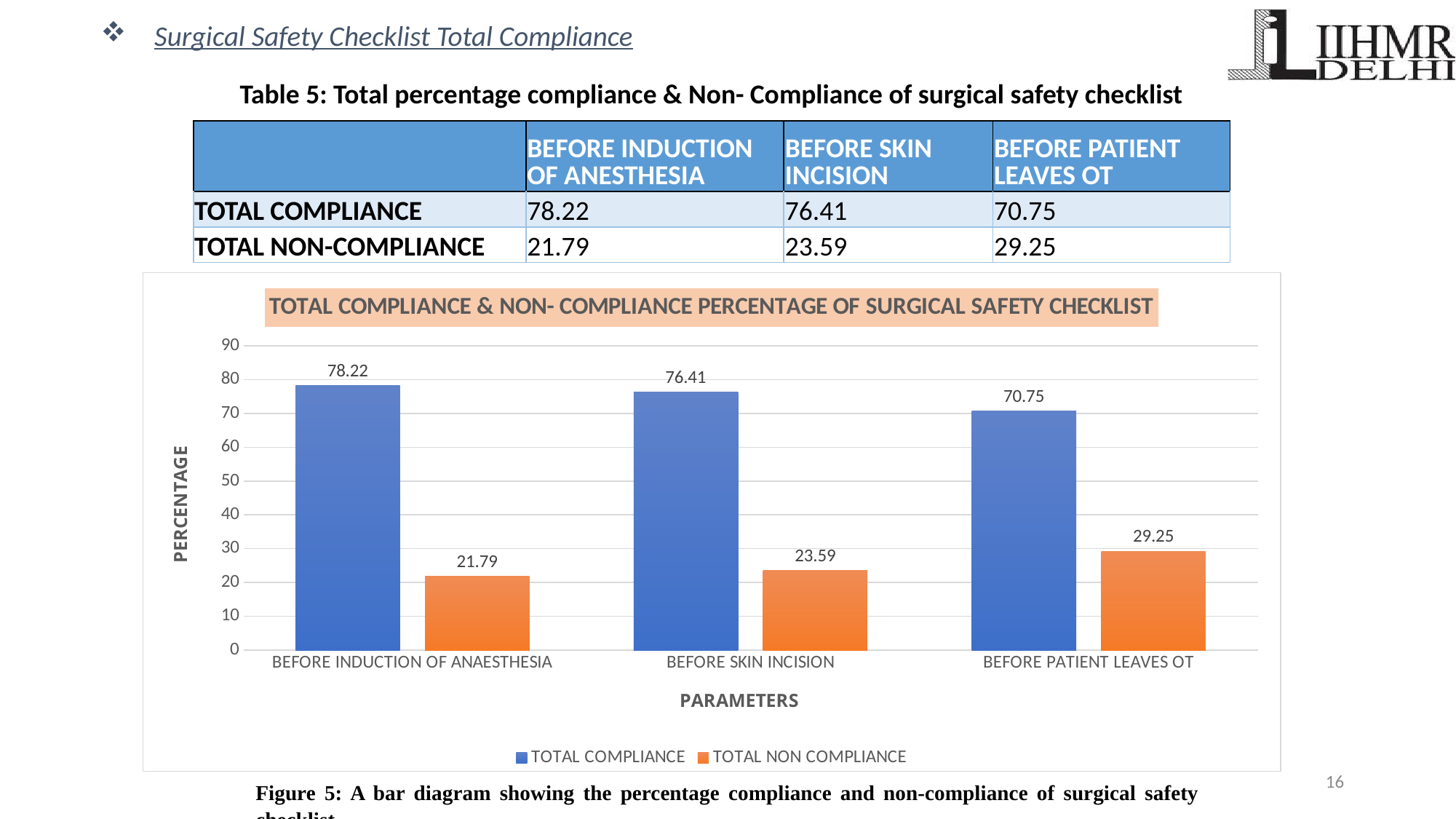
How many parameters are shown on the x axis of the chart? 3 What is the TOTAL NON COMPLIANCE value for BEFORE PATIENT LEAVES OT? 29.25 What kind of chart is shown on the slide? bar chart Do the TOTAL COMPLIANCE values rise or fall from left to right along the x axis? fall Is the TOTAL COMPLIANCE value for BEFORE PATIENT LEAVES OT greater or less than 80? less Which parameter has the lowest TOTAL NON COMPLIANCE value? BEFORE INDUCTION OF ANAESTHESIA Which parameter has the highest TOTAL COMPLIANCE value? BEFORE INDUCTION OF ANAESTHESIA What is the TOTAL COMPLIANCE value for BEFORE INDUCTION OF ANAESTHESIA? 78.22 Which is larger: TOTAL NON COMPLIANCE for BEFORE SKIN INCISION or for BEFORE PATIENT LEAVES OT? BEFORE PATIENT LEAVES OT What is the difference between the TOTAL COMPLIANCE values for BEFORE INDUCTION OF ANAESTHESIA and BEFORE PATIENT LEAVES OT? 7.47 How many series does the chart legend list? 2 What is the TOTAL NON COMPLIANCE value for BEFORE SKIN INCISION? 23.59